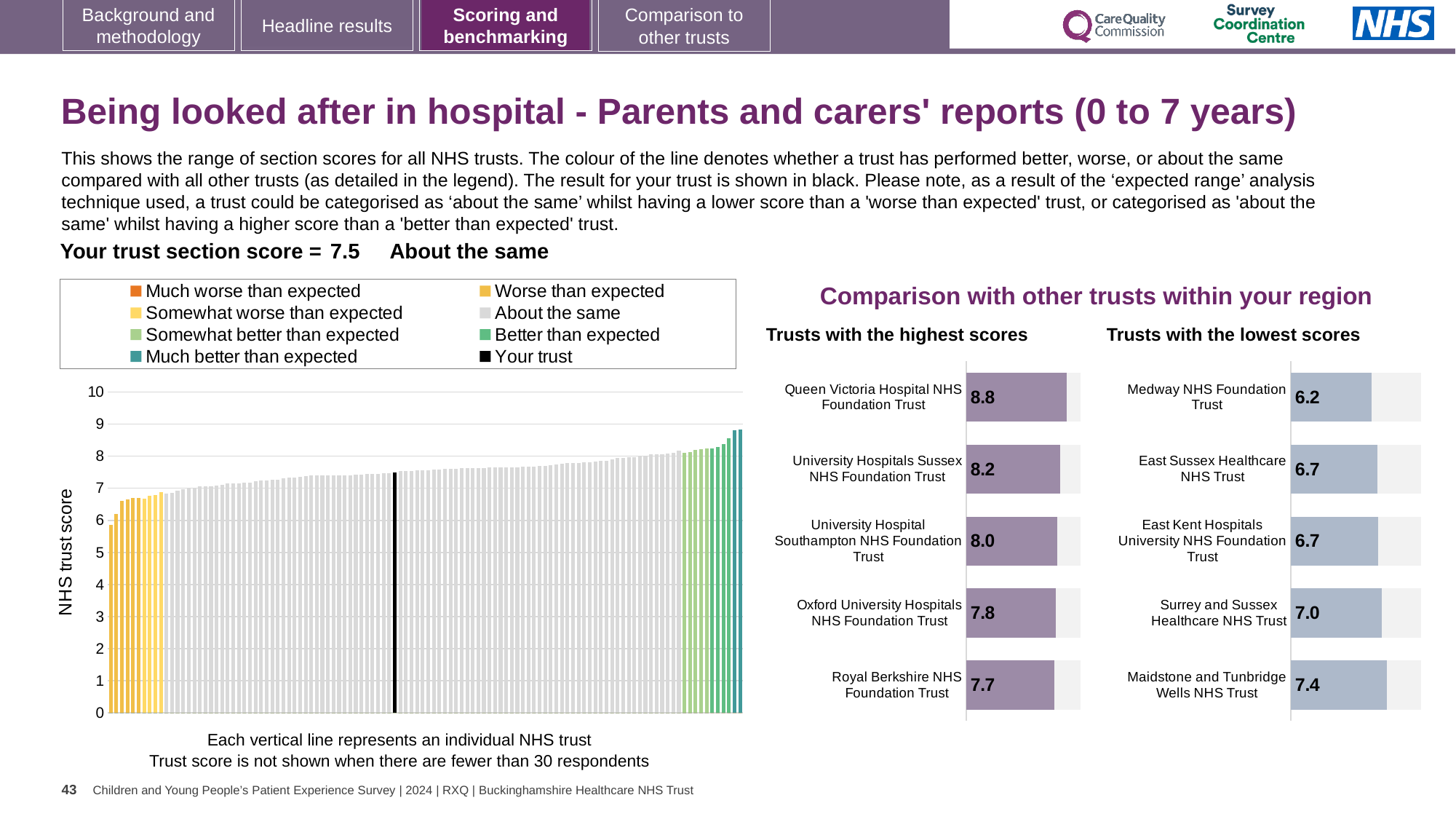
In the 'Trusts with the highest scores' chart, what is the difference between the scores of Queen Victoria Hospital NHS Foundation Trust and Royal Berkshire NHS Foundation Trust? 1.1 In the main chart on the left showing all NHS trusts, is the value for your trust (the black line) greater or less than 5? greater In the main chart on the left showing all NHS trusts, what is the section score for your trust (shown in black)? 7.5 In the 'Trusts with the lowest scores' chart, what is the difference between the scores of Maidstone and Tunbridge Wells NHS Trust and Medway NHS Foundation Trust? 1.2 In the 'Trusts with the highest scores' chart, which trust has the lowest score? Royal Berkshire NHS Foundation Trust How many trusts are shown in the 'Trusts with the lowest scores' chart? 5 In the 'Trusts with the lowest scores' chart, what is the score for Medway NHS Foundation Trust? 6.2 In the 'Trusts with the highest scores' chart, which has the higher score: University Hospitals Sussex NHS Foundation Trust or Oxford University Hospitals NHS Foundation Trust? University Hospitals Sussex NHS Foundation Trust In the 'Trusts with the lowest scores' chart, which trust has the highest score? Maidstone and Tunbridge Wells NHS Trust In the 'Trusts with the highest scores' chart, what is the score for Queen Victoria Hospital NHS Foundation Trust? 8.8 In the main chart on the left showing all NHS trusts, do the trust scores rise or fall from left to right? rise How many entries does the legend of the main chart on the left list? 8